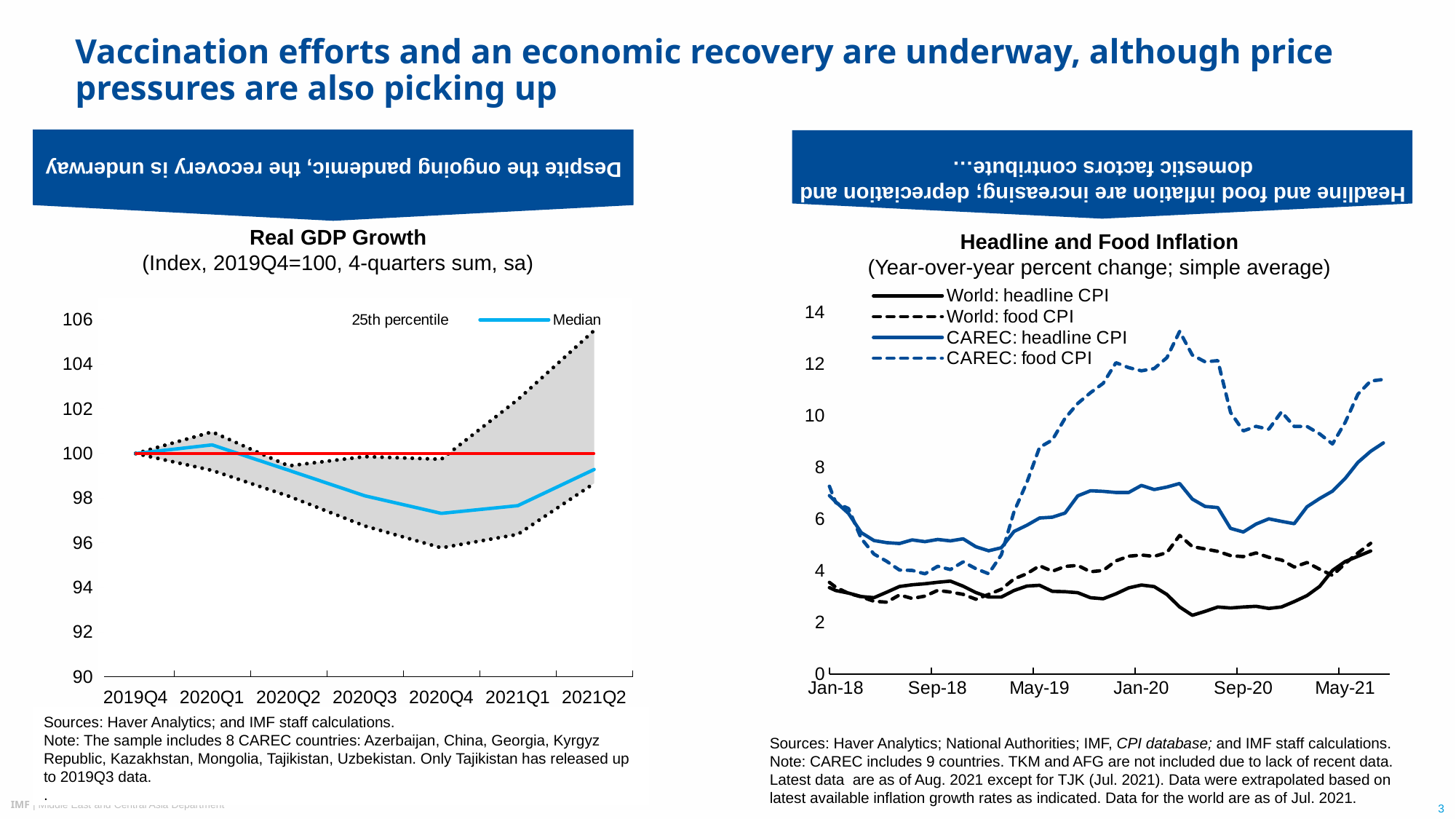
In the Real GDP Growth chart, does the Median series rise or fall from 2019Q4 to 2020Q4? fall According to the subtitle of the Real GDP Growth chart, which quarter is the index base set to 100? 2019Q4 In the Real GDP Growth chart, is the Median value at 2020Q4 greater or less than 98? less In the Headline and Food Inflation chart, which series reaches the highest value on the chart? CAREC: food CPI What kind of chart is the Real GDP Growth chart on the left? line chart In the Headline and Food Inflation chart, at Jan-20, which is higher: CAREC: headline CPI or World: headline CPI? CAREC: headline CPI In the Headline and Food Inflation chart, which series has the lowest value at Sep-20? World: headline CPI How many quarters are labelled on the x axis of the Real GDP Growth chart? 7 How many series does the legend of the Headline and Food Inflation chart list? 4 In the Headline and Food Inflation chart, does the CAREC: headline CPI series rise or fall from Sep-20 to May-21? rise In the Real GDP Growth chart, what is the value of the Median series at 2019Q4? 100